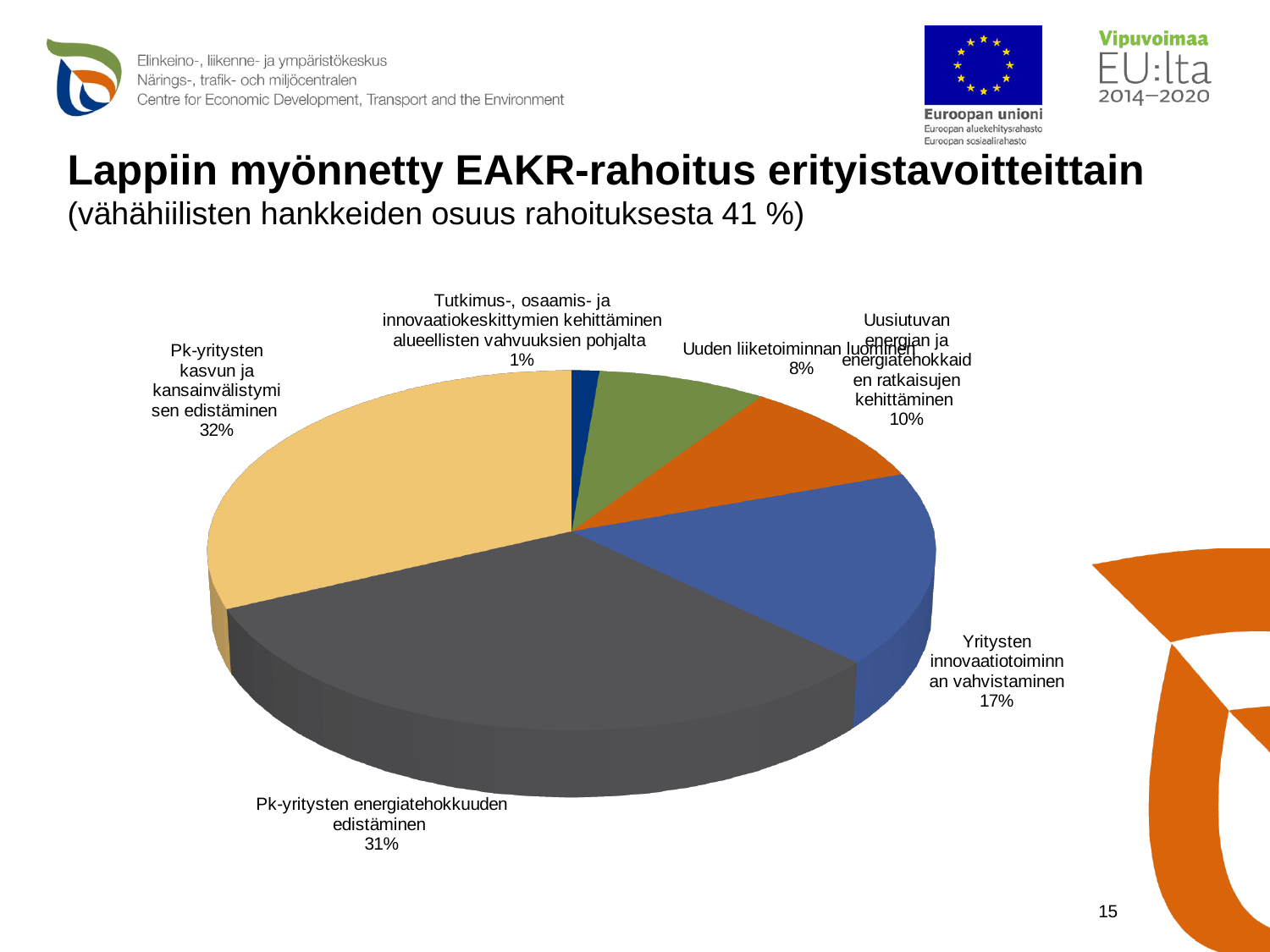
Which category has the largest share of the pie? Pk-yritysten kasvun ja kansainvälistymisen edistäminen How many slices does the pie chart have? 6 What percentage is shown for "Uusiutuvan energian ja energiatehokkaiden ratkaisujen kehittäminen"? 10% What is the difference in percentage points between "Yritysten innovaatiotoiminnan vahvistaminen" and "Uuden liiketoiminnan luominen"? 9 percentage points What type of chart is shown on the slide? Pie chart What share of the pie does "Pk-yritysten kasvun ja kansainvälistymisen edistäminen" have? 32% Which category has the smallest share of the pie? Tutkimus-, osaamis- ja innovaatiokeskittymien kehittäminen alueellisten vahvuuksien pohjalta Which is larger: the share for "Uusiutuvan energian ja energiatehokkaiden ratkaisujen kehittäminen" or for "Uuden liiketoiminnan luominen"? Uusiutuvan energian ja energiatehokkaiden ratkaisujen kehittäminen What is the combined share of the two "Pk-yritysten" categories? 63% What percentage is shown for "Uuden liiketoiminnan luominen"? 8% What share of the pie does "Pk-yritysten energiatehokkuuden edistäminen" have? 31% What percentage is shown for "Yritysten innovaatiotoiminnan vahvistaminen"? 17%